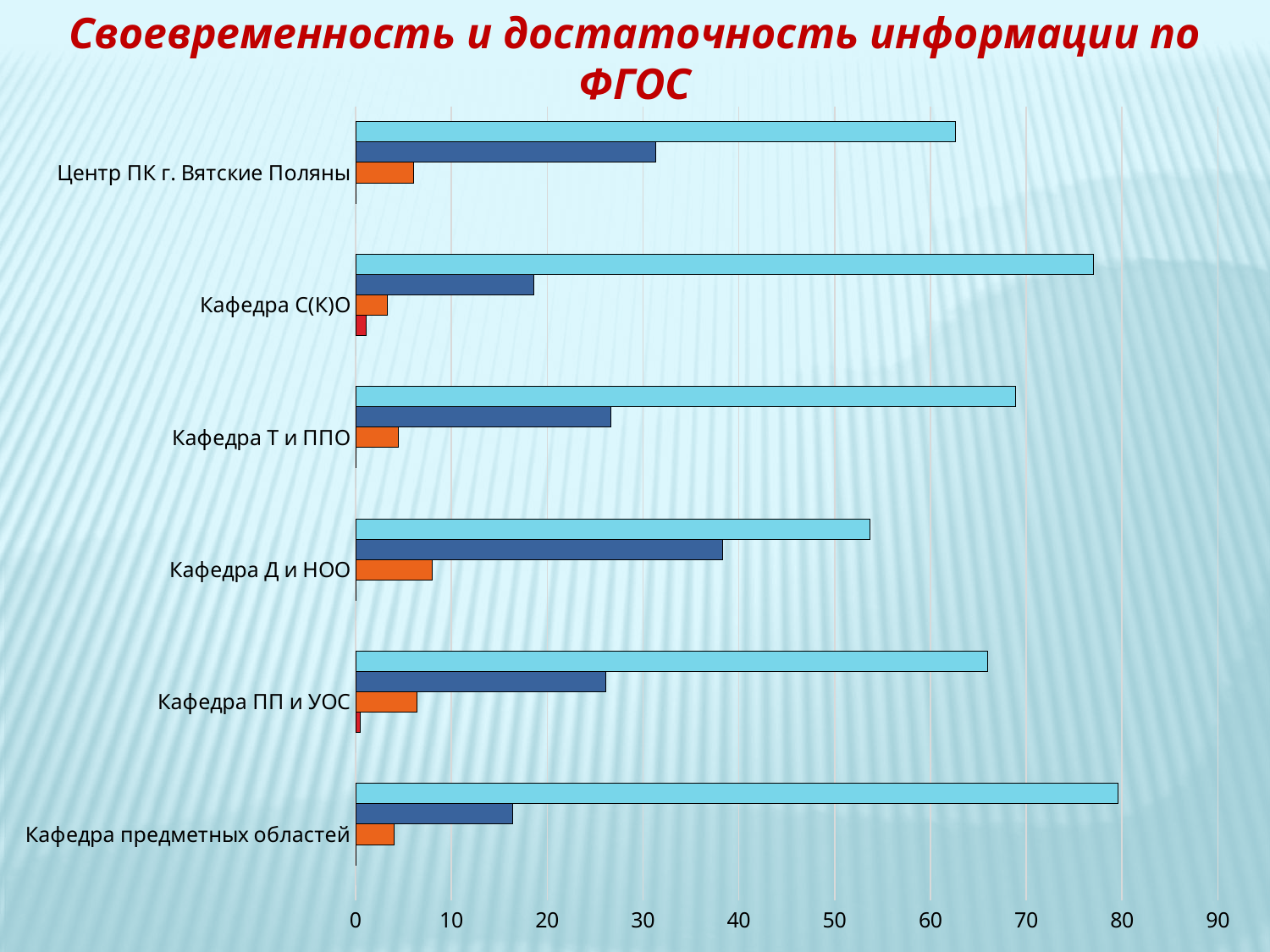
Which category has the shortest light blue bar? Кафедра Д и НОО Is the dark blue bar for Кафедра Т и ППО greater or less than 20? greater Is the light blue bar for Кафедра Д и НОО greater or less than 60? less How many categories (departments) are shown on the chart? 6 What kind of chart is shown on the slide? bar chart Which category has the longest light blue bar? Кафедра предметных областей Which has the longer light blue bar: Кафедра С(К)О or Центр ПК г. Вятские Поляны? Кафедра С(К)О What is the title of the slide? Своевременность и достаточность информации по ФГОС Is the light blue bar for Кафедра С(К)О greater or less than 70? greater Which category has the longest orange bar? Кафедра Д и НОО Which has the longer dark blue bar: Кафедра Д и НОО or Кафедра С(К)О? Кафедра Д и НОО Which category has the longest dark blue bar? Кафедра Д и НОО